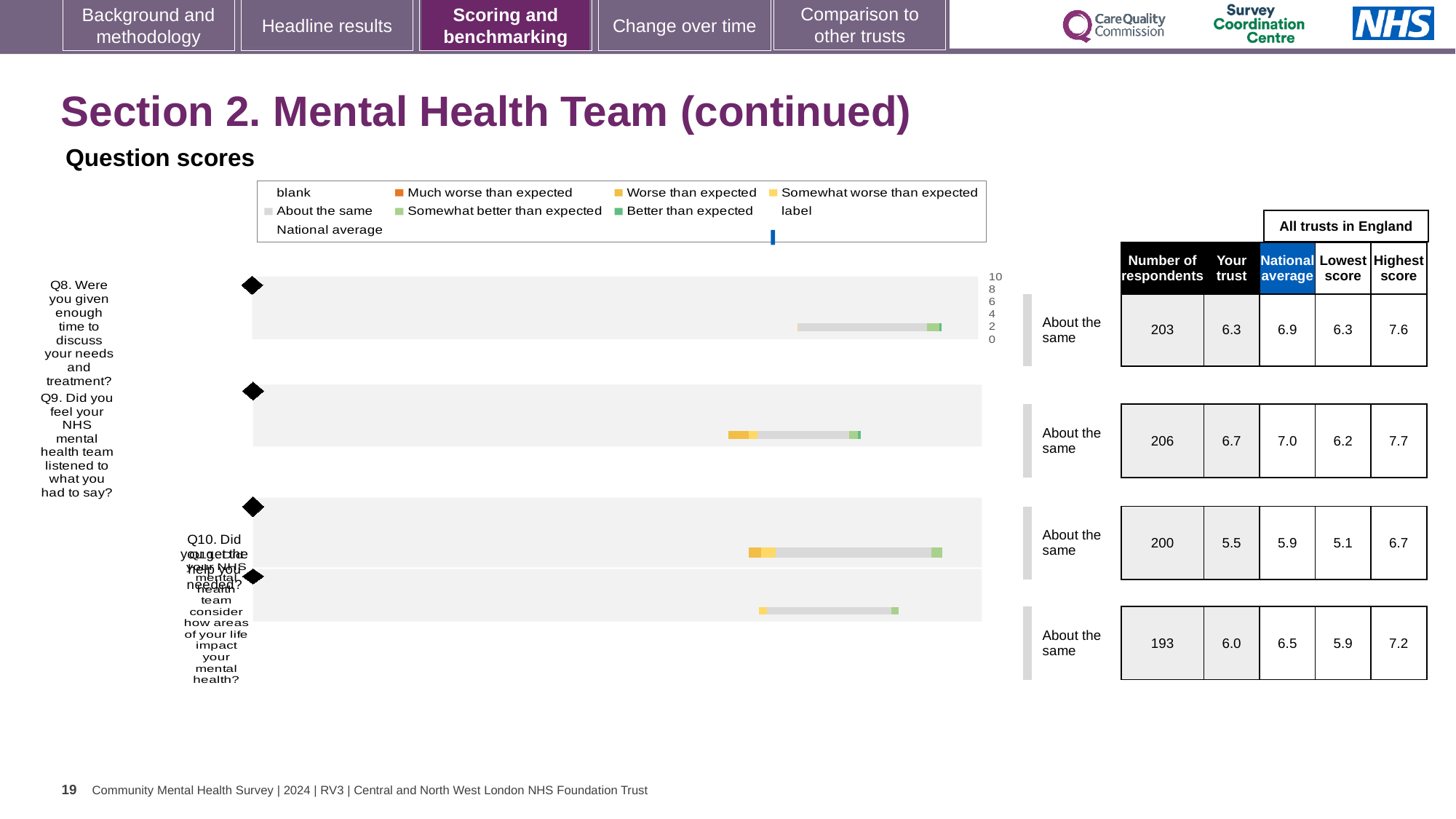
In the table beside the chart, which question has the highest number of respondents? Q9 In the chart legend, what colour represents 'Much worse than expected'? orange In the table beside the chart, what is the highest score among all trusts in England for Q8? 7.6 In the table beside the chart, which question has the lowest 'Your trust' score? Q10 How many question bars are plotted in the chart? 4 In the table beside the chart, is the 'Your trust' score for Q9 higher or lower than the national average for Q9? lower In the table beside the chart, what is the national average for Q10 (Did you get the help you needed?)? 5.9 What benchmark category is shown next to each of the four question bars? About the same What kind of chart is used to show the question scores on this slide? bar chart In the table beside the chart, what is the difference between the national average and the 'Your trust' score for Q8? 0.6 In the table beside the chart, how many respondents answered Q8 (Were you given enough time to discuss your needs and treatment?)? 203 In the table beside the chart, what is the 'Your trust' score for Q9 (Did you feel your NHS mental health team listened to what you had to say?)? 6.7